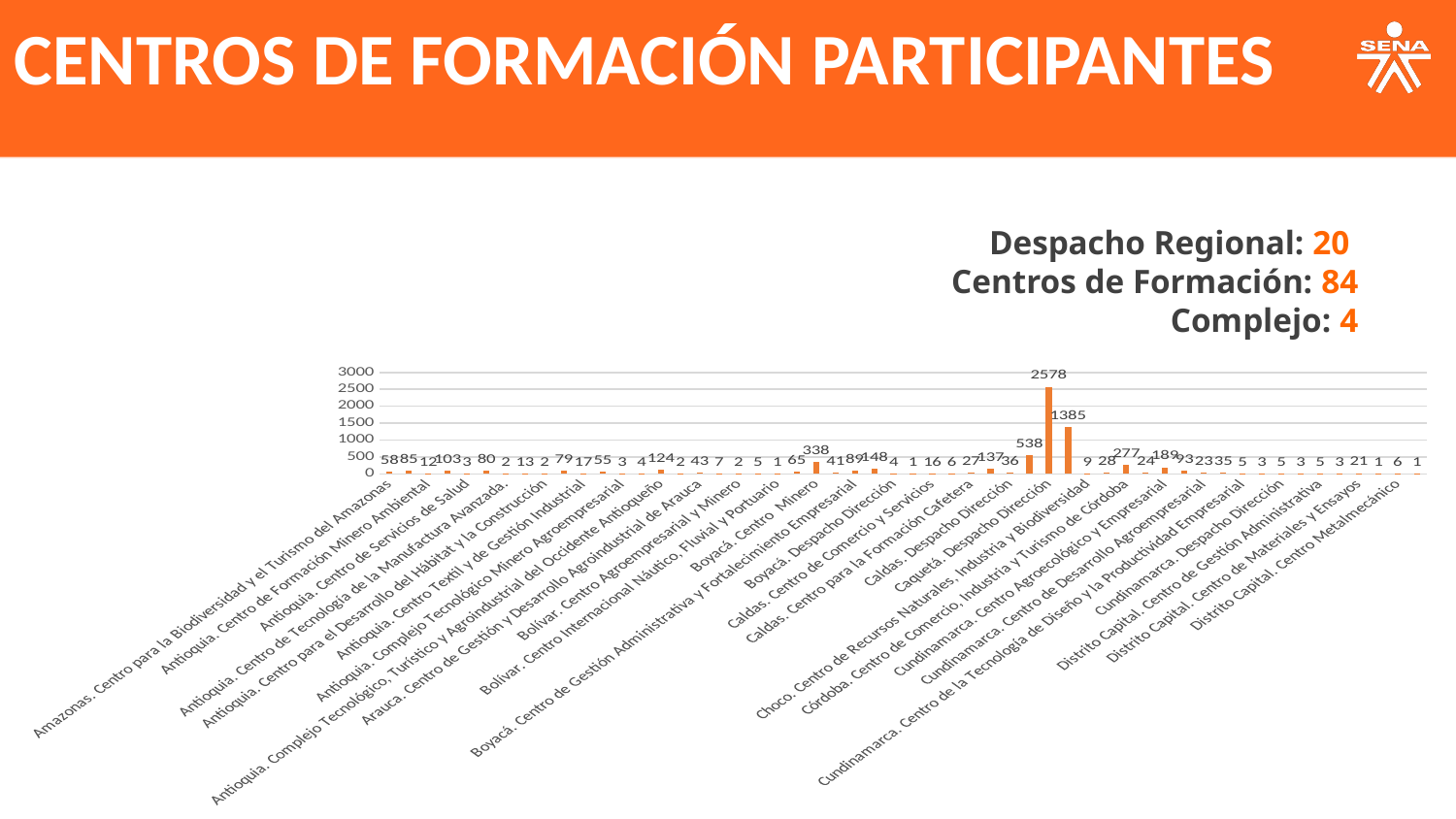
What is the difference between the two tallest bars, 2578 and 1385? 1193 Which category has the highest bar in the chart? Caquetá. Despacho Dirección What is the value of the second-tallest bar in the chart? 1385 Which is larger, the bar labelled 538 or the bar labelled 338? 538 What is the difference between the bars labelled 538 and 338? 200 Which is larger, the bar labelled 2578 or the bar labelled 1385? 2578 What kind of chart is shown on the slide? bar chart What is the highest value shown in the chart? 2578 Is the value for Caquetá. Despacho Dirección greater or less than 2500? greater What colour are the bars in the chart? orange What is the maximum value shown on the vertical axis? 3000